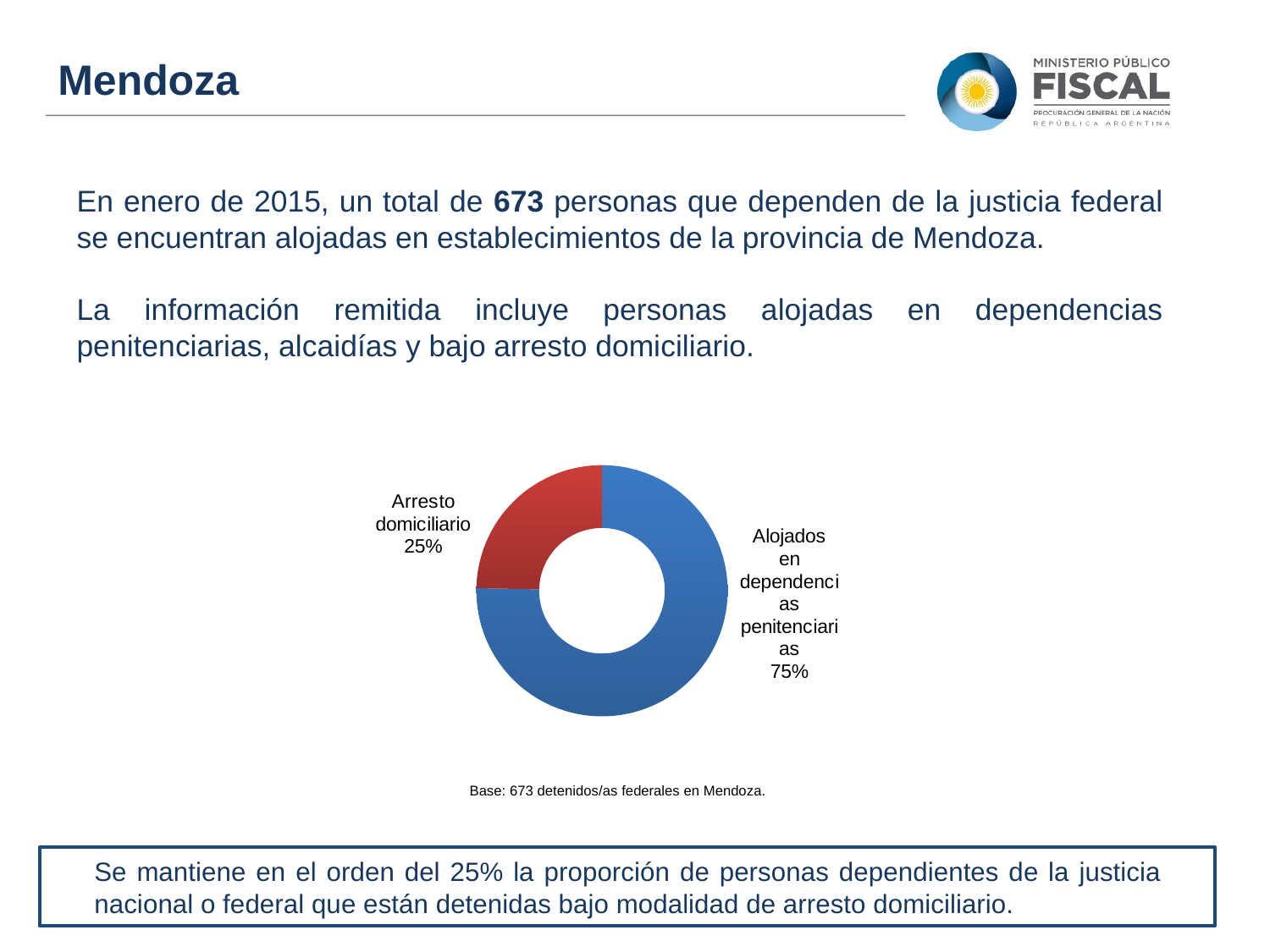
What base (total number of detainees) does the chart note state? 673 detenidos/as federales en Mendoza What percentage of the chart corresponds to 'Alojados en dependencias penitenciarias'? 75% How many categories are shown in the chart? 2 Which category has the smallest share of the chart? Arresto domiciliario Which is larger: the share for 'Arresto domiciliario' or the share for 'Alojados en dependencias penitenciarias'? Alojados en dependencias penitenciarias What is the combined share of the two slices in the chart? 100% What percentage of the chart corresponds to 'Arresto domiciliario'? 25% What colour is the 'Arresto domiciliario' slice? Red What is the difference in percentage points between 'Alojados en dependencias penitenciarias' and 'Arresto domiciliario'? 50 percentage points What kind of chart is shown on the slide? Doughnut (pie) chart Which category has the largest share of the chart? Alojados en dependencias penitenciarias